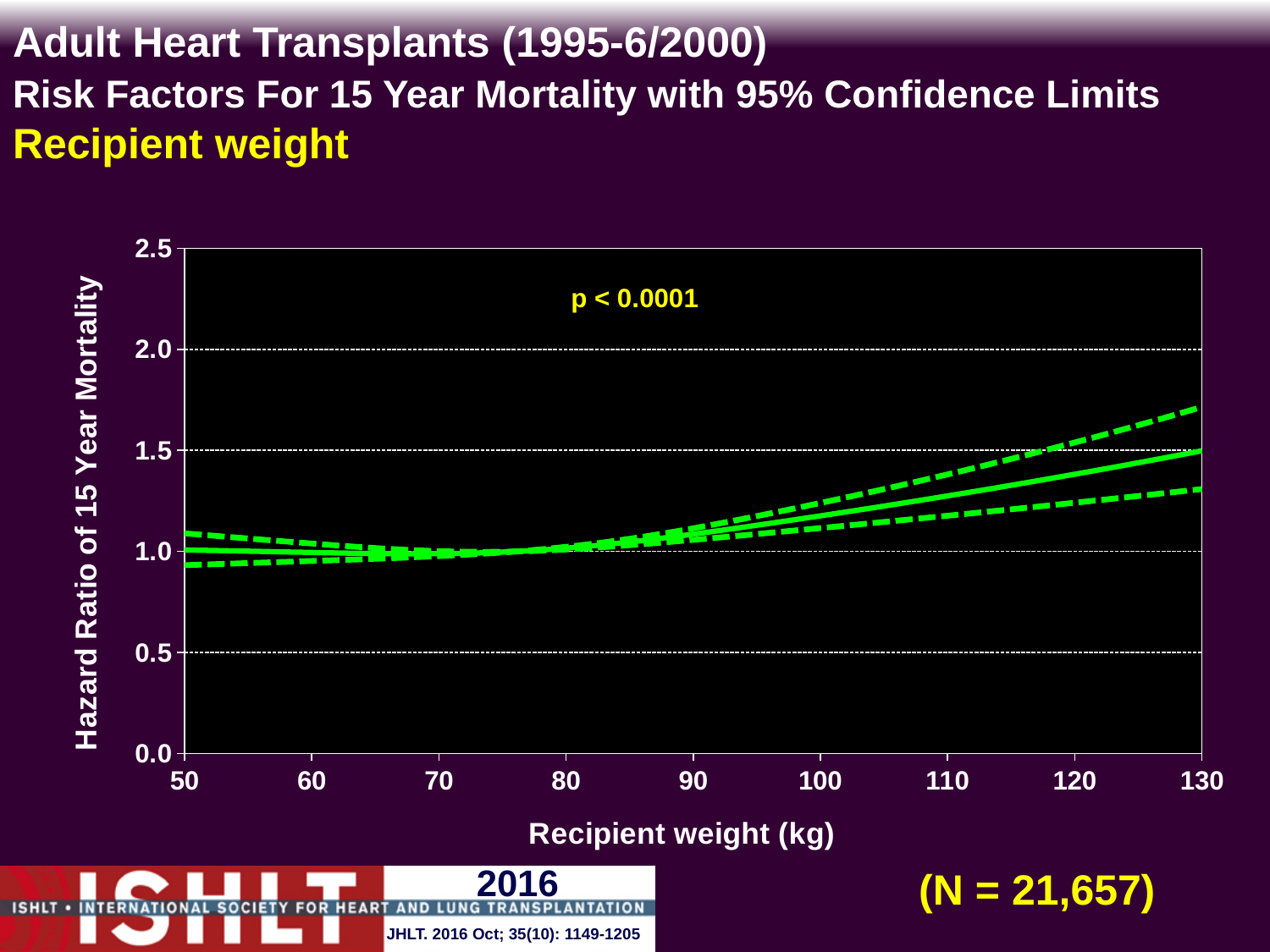
What is the label of the x axis? Recipient weight (kg) Is the lower confidence limit (lower dashed line) at a recipient weight of 50 kg greater or less than 1.0? less What is the highest value shown on the y axis? 2.5 What kind of chart is shown on the slide? line chart How many labelled tick marks are on the x axis? 9 Is the hazard ratio (solid line) at a recipient weight of 110 kg greater or less than 1.5? less Does the hazard ratio (solid line) rise or fall as recipient weight increases from 80 kg to 130 kg? rise Is the hazard ratio (solid line) at a recipient weight of 130 kg higher or lower than at 50 kg? higher Is the hazard ratio (solid line) at a recipient weight of 130 kg greater or less than 1.0? greater What is the p-value printed on the chart? p < 0.0001